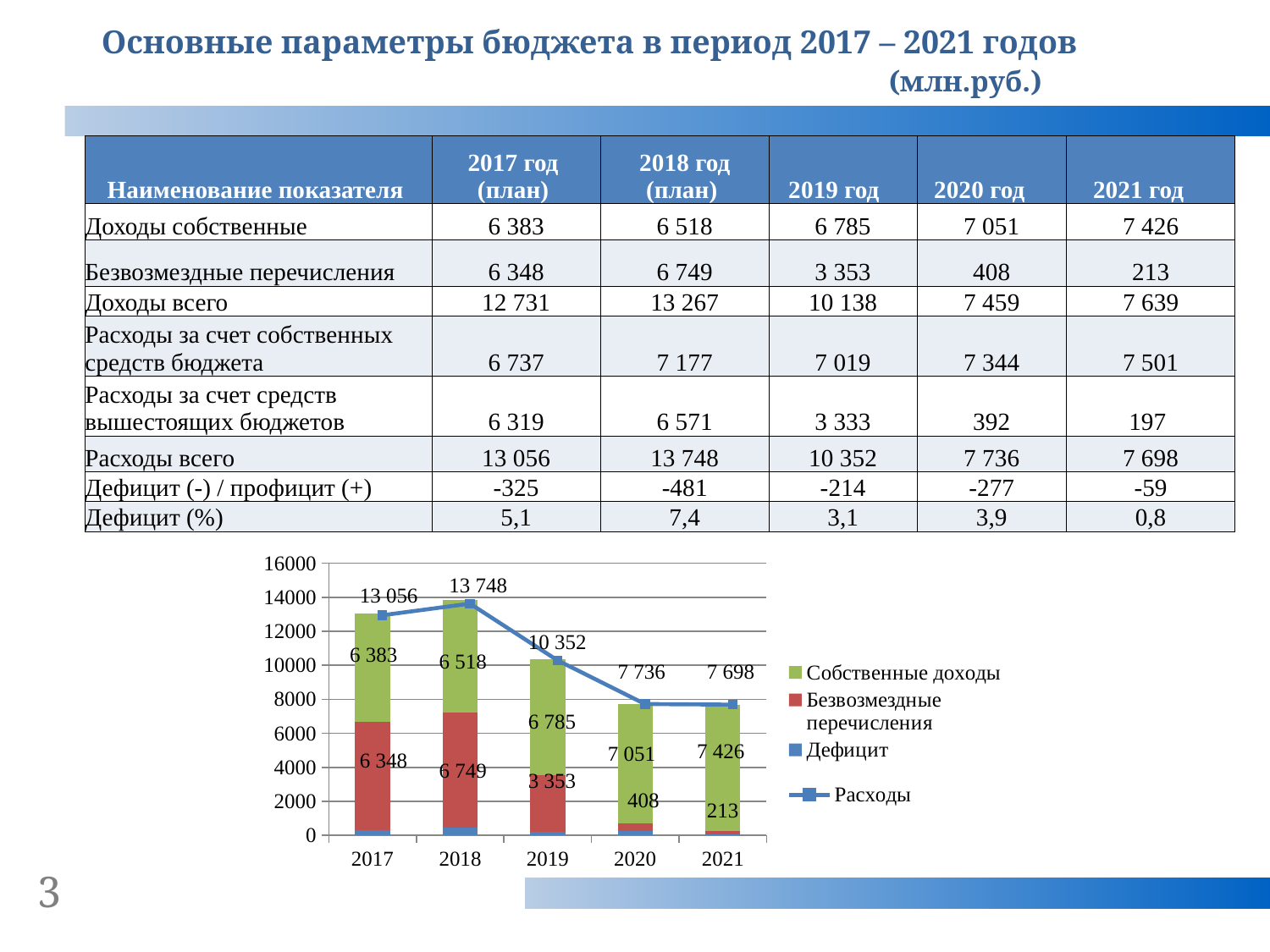
How many years are shown on the x axis of the chart? 5 In the chart, which year has the highest value of Безвозмездные перечисления? 2018 What kind of chart is shown on the slide? Stacked bar chart with a line In the chart, what is the value of Безвозмездные перечисления for 2019? 3 353 In the chart, which year has the lowest value on the Расходы line? 2021 In the chart, what value does the Расходы line show for 2018? 13 748 In the chart, what is the value of Собственные доходы for 2021? 7 426 In the chart, what is the difference between Собственные доходы in 2021 and in 2017? 1 043 How many series does the chart legend list? 4 In the chart, is Безвозмездные перечисления larger in 2020 or in 2021? 2020 In the chart, is the Расходы value for 2019 greater or less than 10000? greater In the chart, does Собственные доходы rise or fall from 2017 to 2021? rise